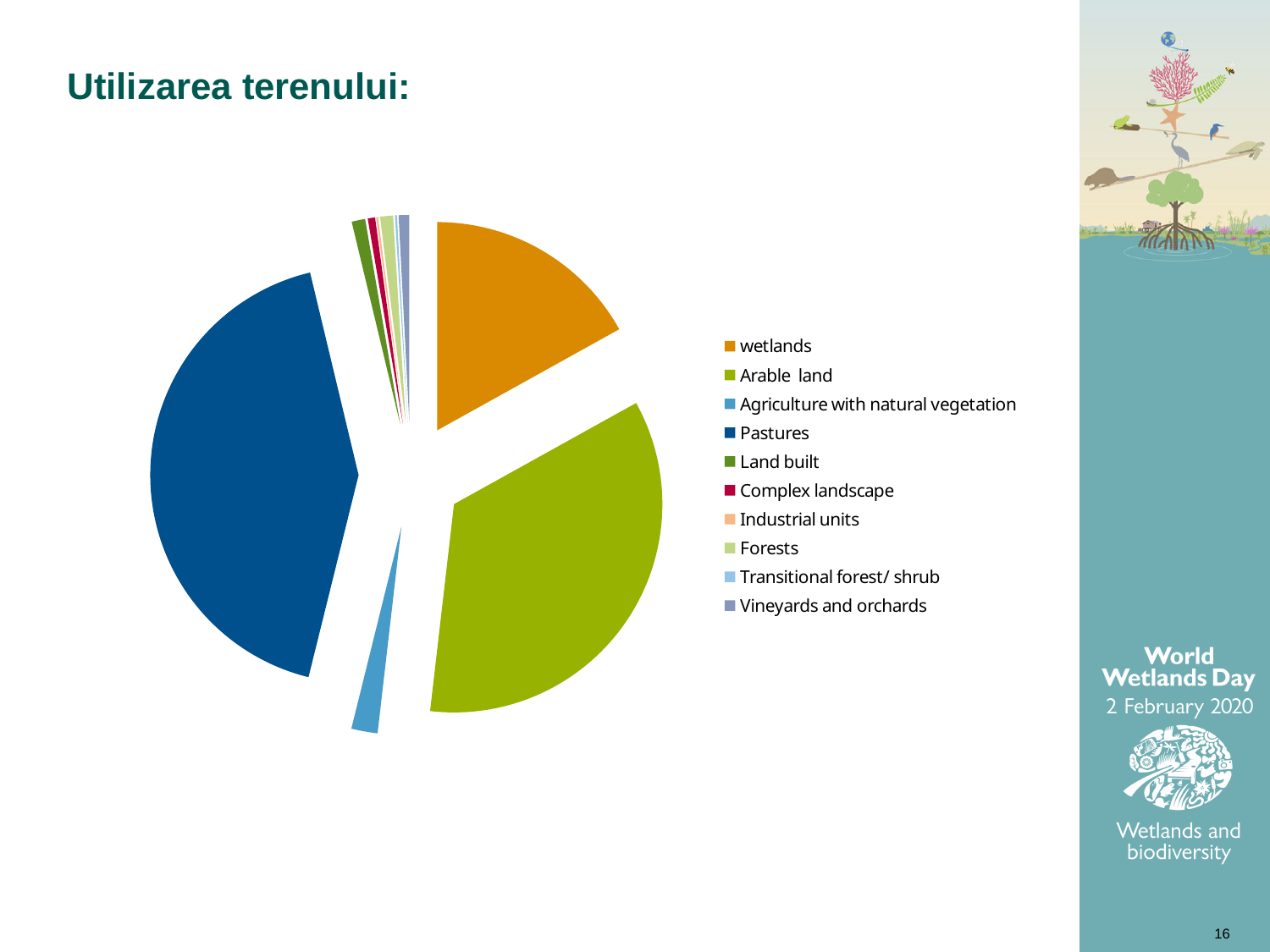
Which slice is larger, wetlands or Agriculture with natural vegetation? wetlands Which category is shown in orange in the pie chart's legend? wetlands Which slice is larger, Pastures or wetlands? Pastures What kind of chart is shown on the slide? pie chart Which slice is larger, Pastures or Arable land? Pastures What is the title of the slide containing the pie chart? Utilizarea terenului: Which category has the largest slice of the pie chart? Pastures How many categories does the pie chart's legend list? 10